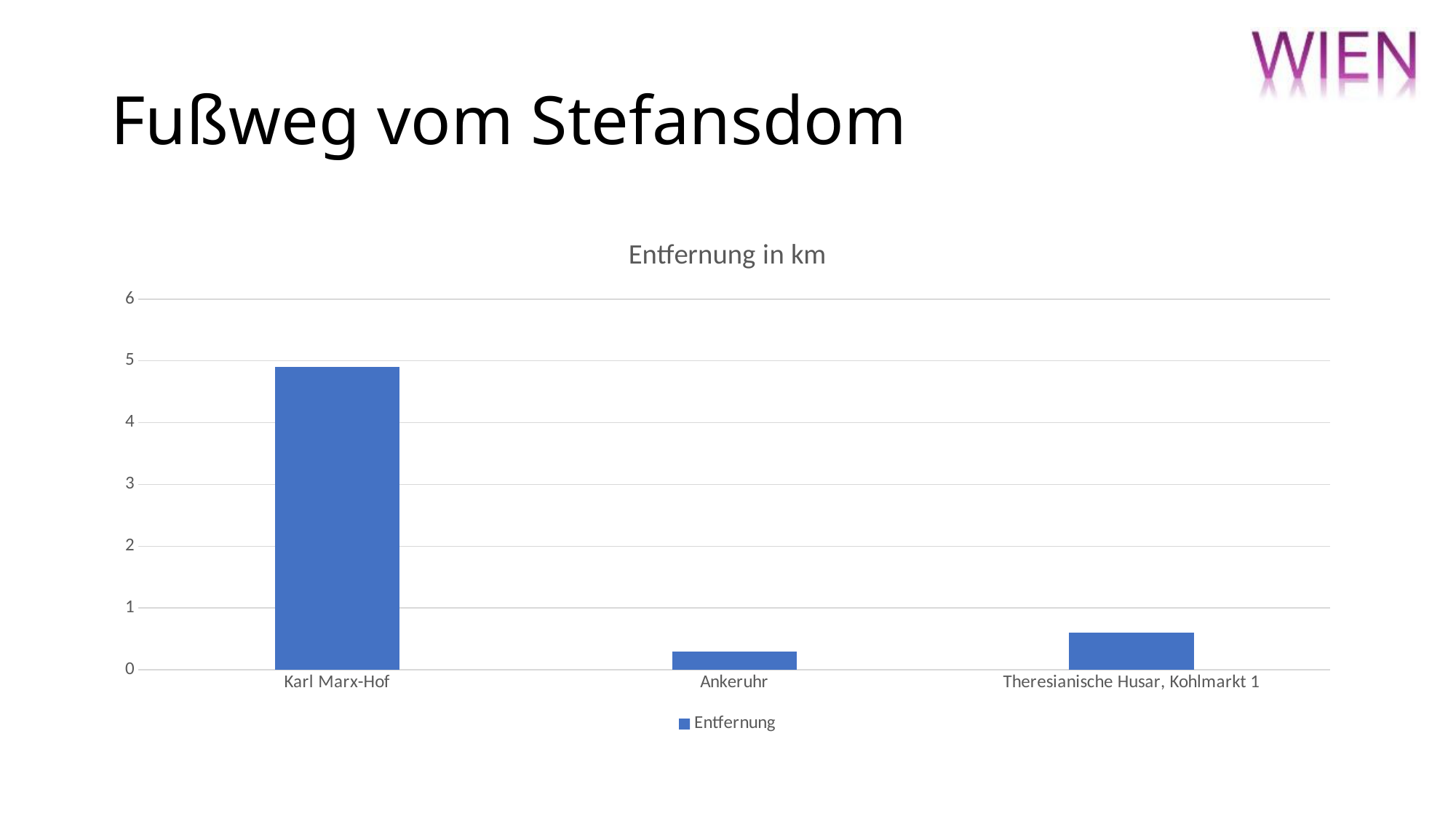
How many categories are shown on the x axis of the chart? 3 What is the title of the chart? Entfernung in km How many series does the chart's legend list? 1 What kind of chart is shown on the slide? bar chart Which category has the lowest value in the chart? Ankeruhr Is the value for Karl Marx-Hof greater or less than 4? greater Which has a larger value, Karl Marx-Hof or Ankeruhr? Karl Marx-Hof Which category has the highest value in the chart? Karl Marx-Hof Is the value for Theresianische Husar, Kohlmarkt 1 greater or less than 1? less Which has a larger value, Ankeruhr or Theresianische Husar, Kohlmarkt 1? Theresianische Husar, Kohlmarkt 1 What is the name of the series listed in the legend? Entfernung Is the value for Ankeruhr greater or less than 1? less